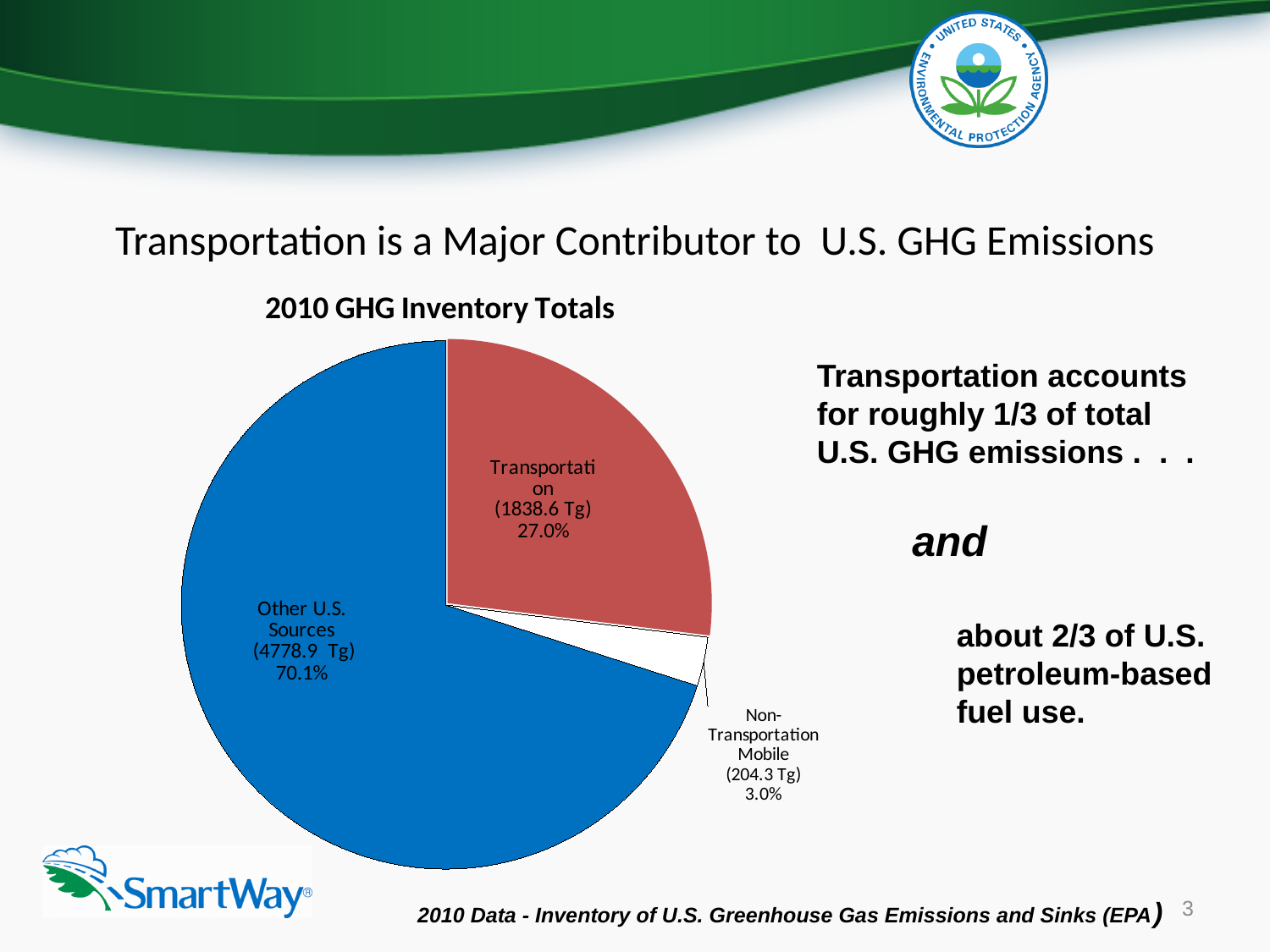
Which slice is the smallest? Non-Transportation Mobile How many slices does the pie chart have? 3 What share of the pie does Transportation account for? 27.0% Which slice is the largest? Other U.S. Sources What is the title of the chart? 2010 GHG Inventory Totals What share of the pie does Other U.S. Sources account for? 70.1% What share of the pie does Non-Transportation Mobile account for? 3.0% What is the value in Tg for Other U.S. Sources? 4778.9 Tg What is the value in Tg for Non-Transportation Mobile? 204.3 Tg What kind of chart is shown on the slide? pie chart What is the value in Tg for Transportation? 1838.6 Tg What is the difference in Tg between Other U.S. Sources and Transportation? 2940.3 Tg